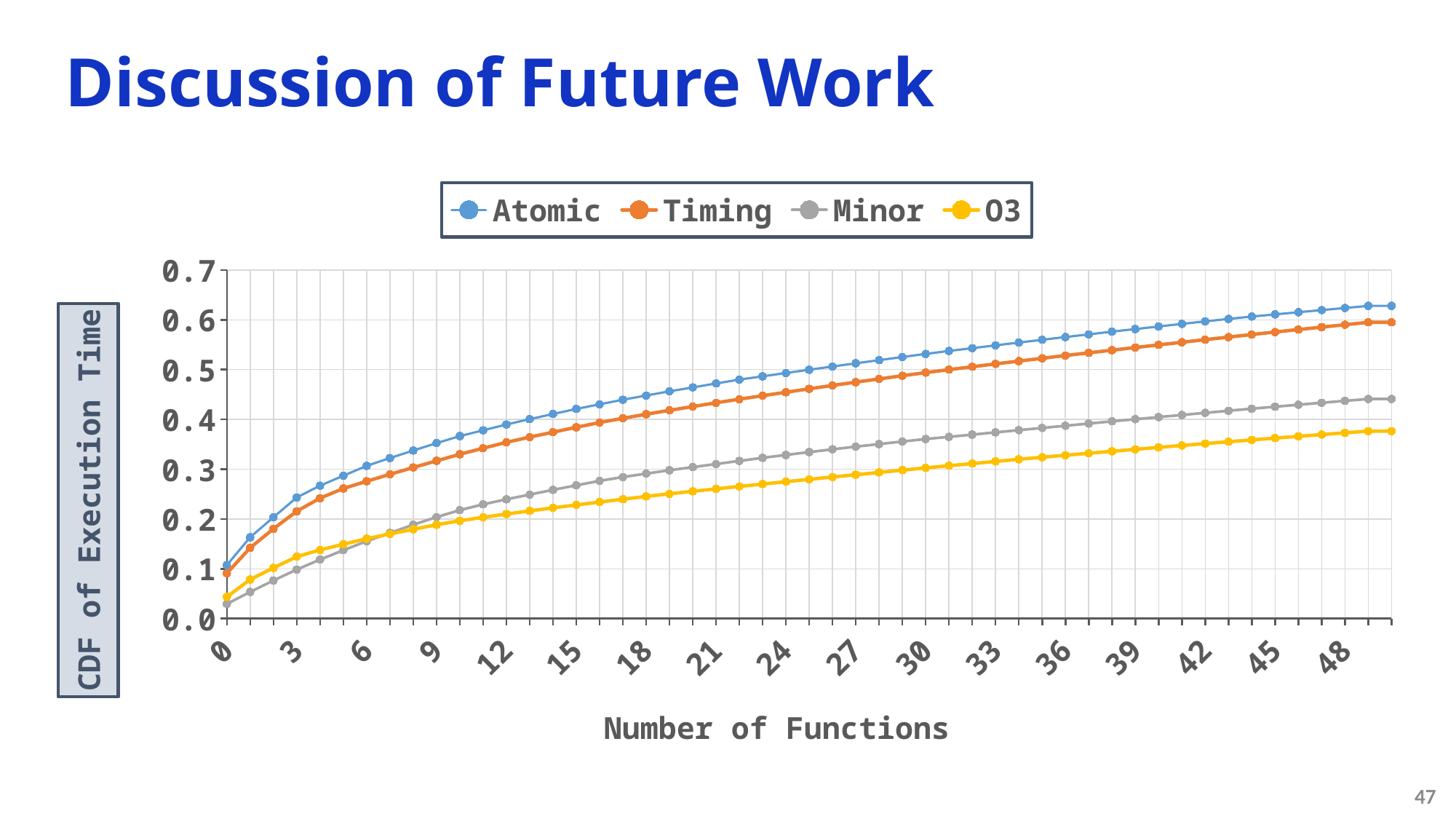
What kind of chart is shown on the slide? Line chart Which series has the highest CDF of Execution Time at 48 functions? Atomic At 3 functions, which series has the larger value, Minor or O3? O3 Is the value for Atomic at 30 functions greater or less than 0.5? greater Is the value for Atomic at 48 functions greater or less than 0.6? greater At 48 functions, which series has the larger value, Minor or O3? Minor What is the title of the y axis? CDF of Execution Time Is the value for Minor at 0 functions greater or less than 0.1? less How many series does the legend list? 4 Do the values of the Atomic series rise or fall as the Number of Functions increases? Rise Which series has the lowest CDF of Execution Time at 48 functions? O3